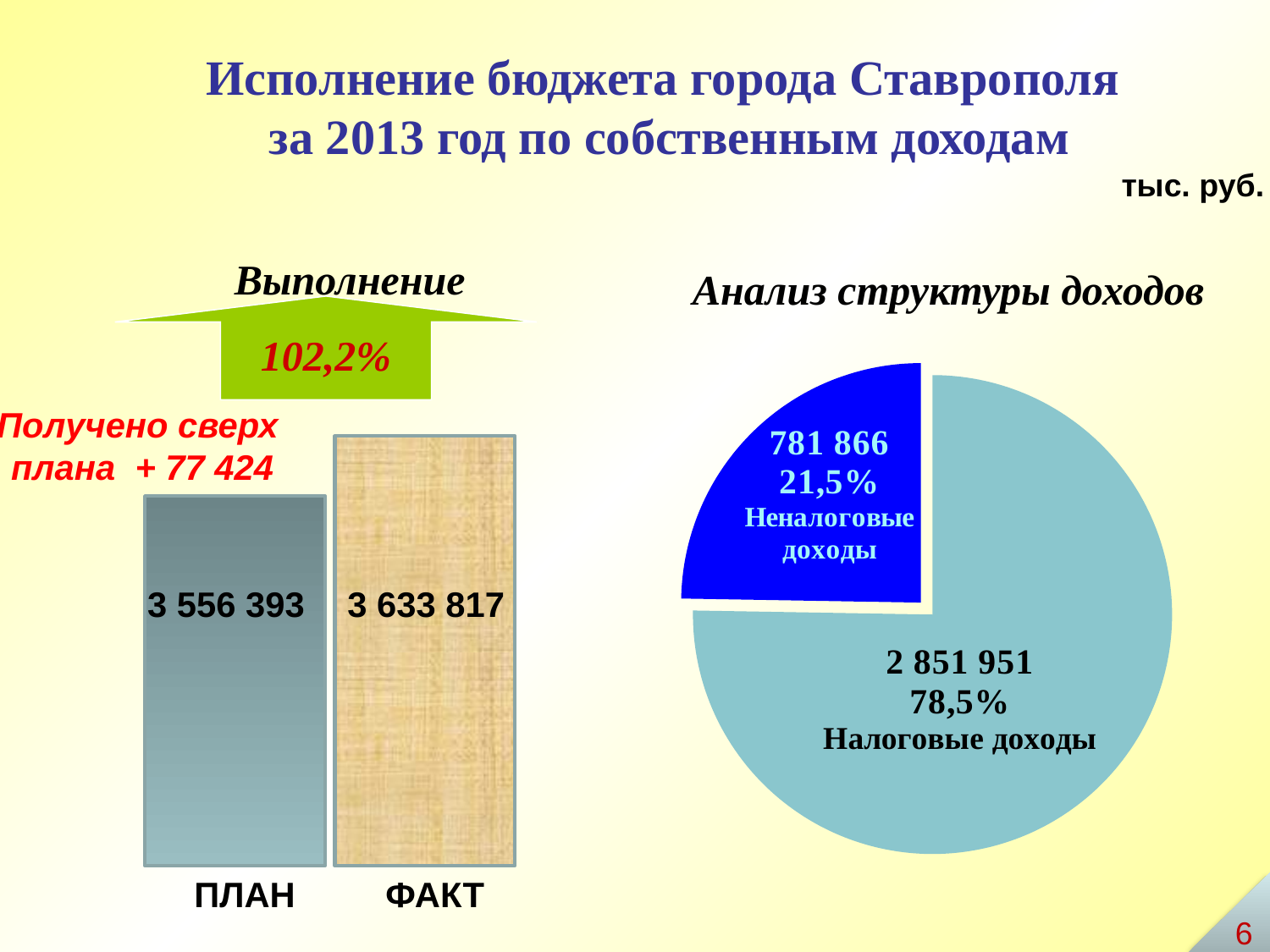
In the bar chart on the left, what is the value for ФАКТ? 3 633 817 In the pie chart 'Анализ структуры доходов', what share of the pie is Налоговые доходы? 78,5% In the bar chart on the left, what is the value for ПЛАН? 3 556 393 In the bar chart on the left, what is the difference between ФАКТ and ПЛАН? 77 424 In the bar chart on the left, how many bars are shown? 2 What kind of chart is shown on the left of the slide? Bar chart In the bar chart on the left, which bar is higher, ПЛАН or ФАКТ? ФАКТ In the pie chart 'Анализ структуры доходов', what is the value for Налоговые доходы? 2 851 951 In the pie chart 'Анализ структуры доходов', what share of the pie is Неналоговые доходы? 21,5% What kind of chart is shown on the right of the slide? Pie chart In the pie chart 'Анализ структуры доходов', what is the value for Неналоговые доходы? 781 866 In the pie chart 'Анализ структуры доходов', which slice is the largest? Налоговые доходы